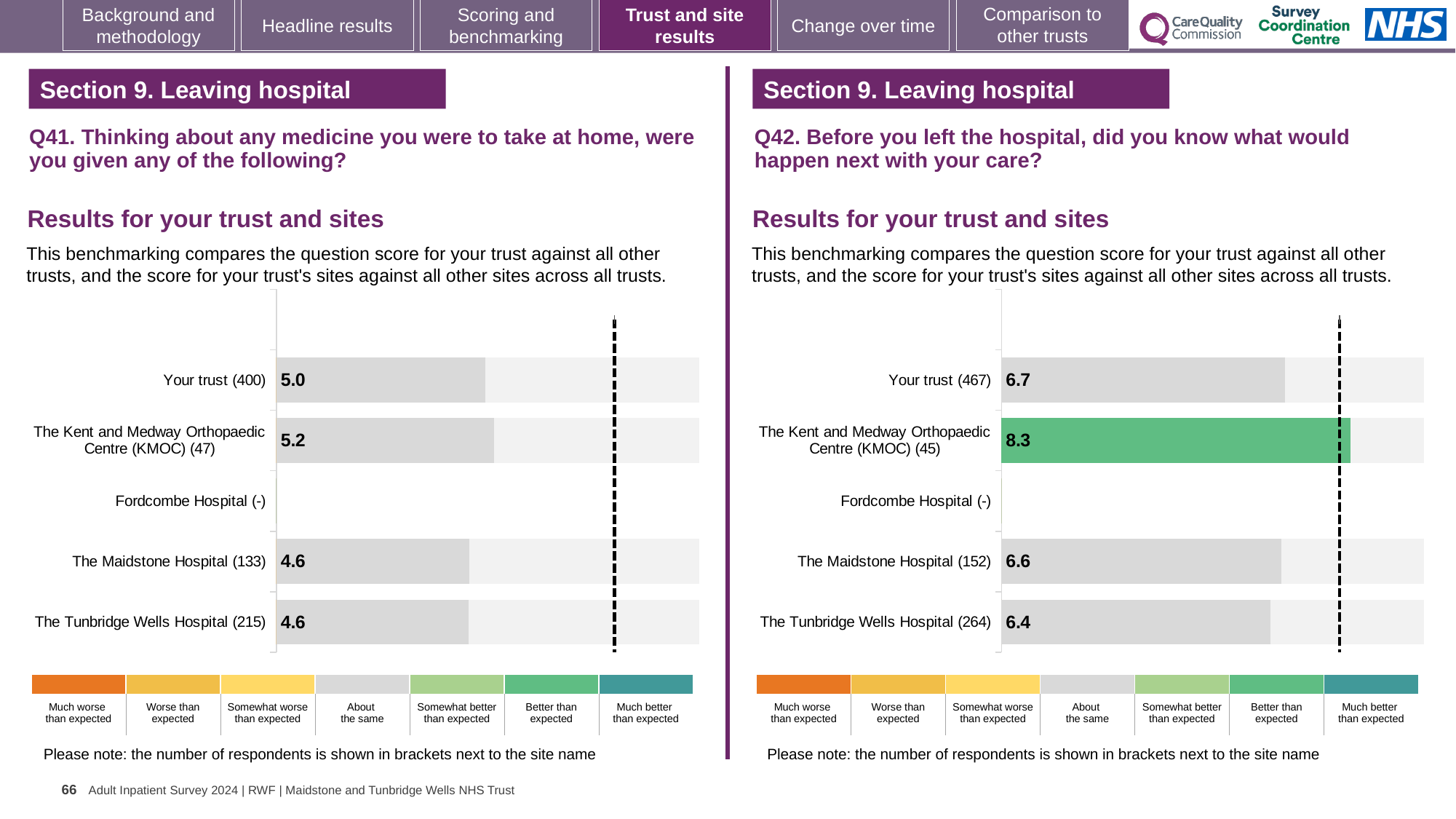
In the Q42 chart, what is the score for The Tunbridge Wells Hospital (264)? 6.4 In the Q42 chart, what is the difference between the score for The Kent and Medway Orthopaedic Centre (KMOC) and the score for Your trust? 1.6 In the Q41 chart, which site has the highest score? The Kent and Medway Orthopaedic Centre (KMOC) In the Q42 chart, which is larger: the score for Your trust or the score for The Maidstone Hospital? Your trust In the Q42 chart, what is the score for The Kent and Medway Orthopaedic Centre (KMOC) (45)? 8.3 What kind of chart is used for the Q41 results? Bar chart In the Q41 chart, what is the score for The Kent and Medway Orthopaedic Centre (KMOC) (47)? 5.2 In the Q41 chart, what is the difference between the score for The Kent and Medway Orthopaedic Centre (KMOC) and the score for The Maidstone Hospital? 0.6 In the Q42 chart, which site has the lowest score among those with a score shown? The Tunbridge Wells Hospital In the Q41 chart, what is the score for Your trust (400)? 5.0 In the Q41 chart, how many sites or trust rows are listed on the vertical axis? 5 In the Q42 chart, which benchmarking category does the colour of The Kent and Medway Orthopaedic Centre (KMOC) bar indicate? Better than expected